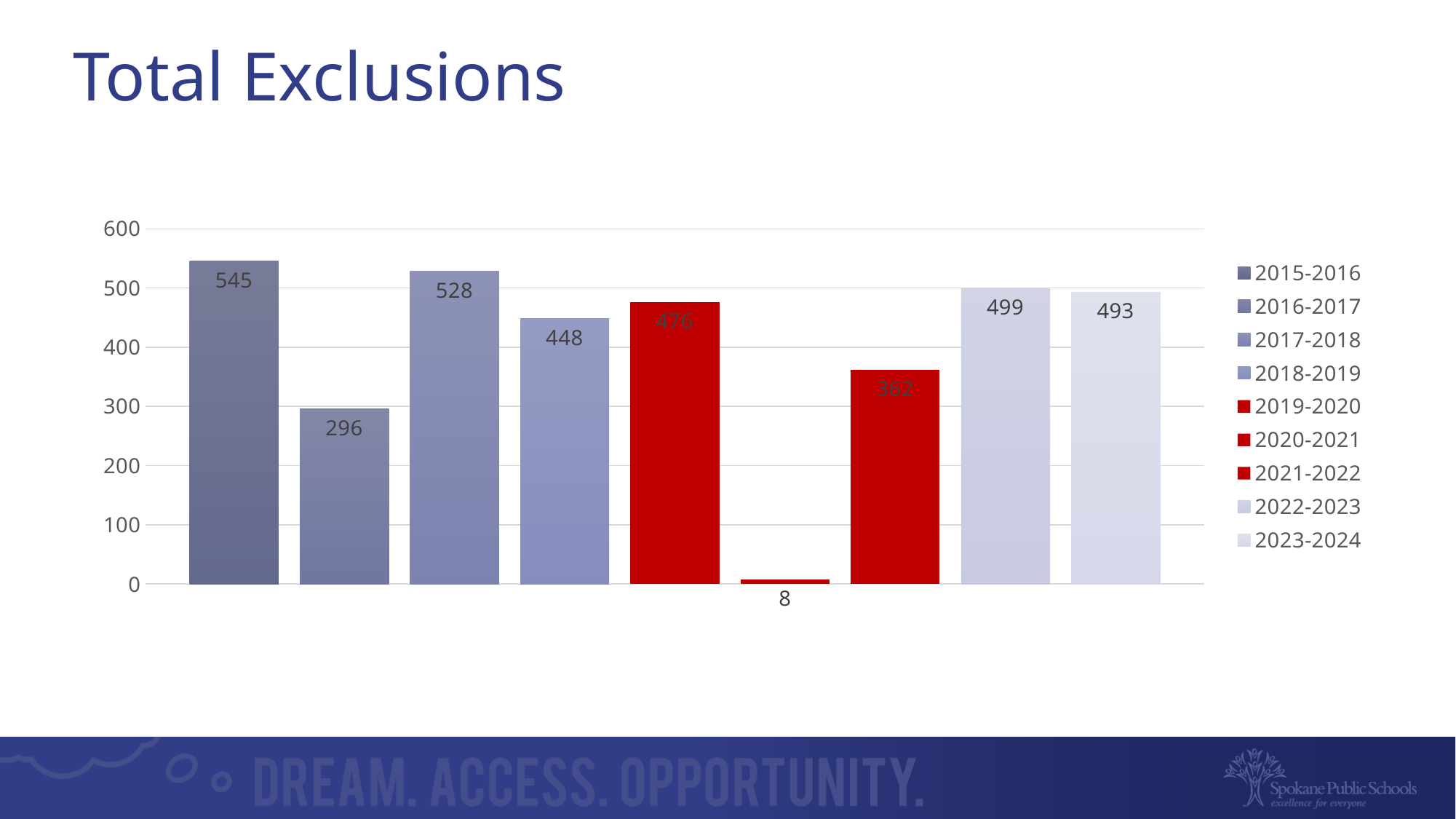
How many school years are plotted in the chart? 9 What kind of chart is shown on the slide? bar chart What is the value for 2022-2023? 499 Which is larger, the value for 2019-2020 or the value for 2021-2022? 2019-2020 Is the value for 2018-2019 greater or less than 400? greater Which school year has the lowest total exclusions? 2020-2021 What is the value for 2020-2021? 8 What is the difference between the values for 2017-2018 and 2016-2017? 232 How many entries does the legend list? 9 What is the value for 2015-2016? 545 Which school year has the highest total exclusions? 2015-2016 Which legend entries are shown in red? 2019-2020, 2020-2021, 2021-2022